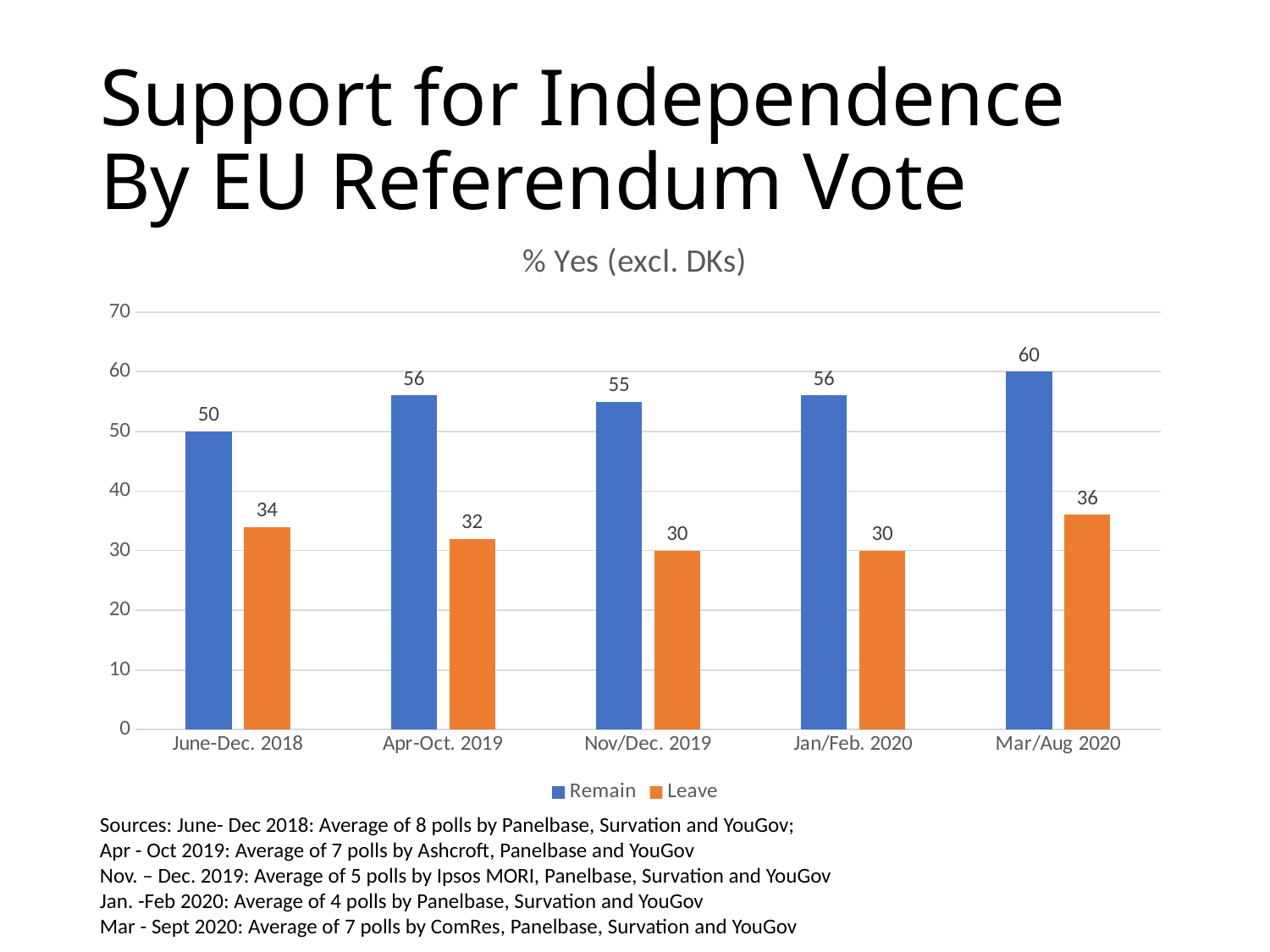
How many series does the legend list? 2 What is the value for Leave in Nov/Dec. 2019? 30 Which is larger in Jan/Feb. 2020, Remain or Leave? Remain In which period is the Leave value lowest? Nov/Dec. 2019 and Jan/Feb. 2020 What is the chart's title? % Yes (excl. DKs) What kind of chart is shown? Bar chart Does the Remain value rise or fall from Jan/Feb. 2020 to Mar/Aug 2020? Rise What is the value for Remain in June-Dec. 2018? 50 What is the difference between Remain and Leave in Apr-Oct. 2019? 24 How many time periods are shown on the x axis? 5 What is the value for Leave in Mar/Aug 2020? 36 In which period is the Remain value highest? Mar/Aug 2020